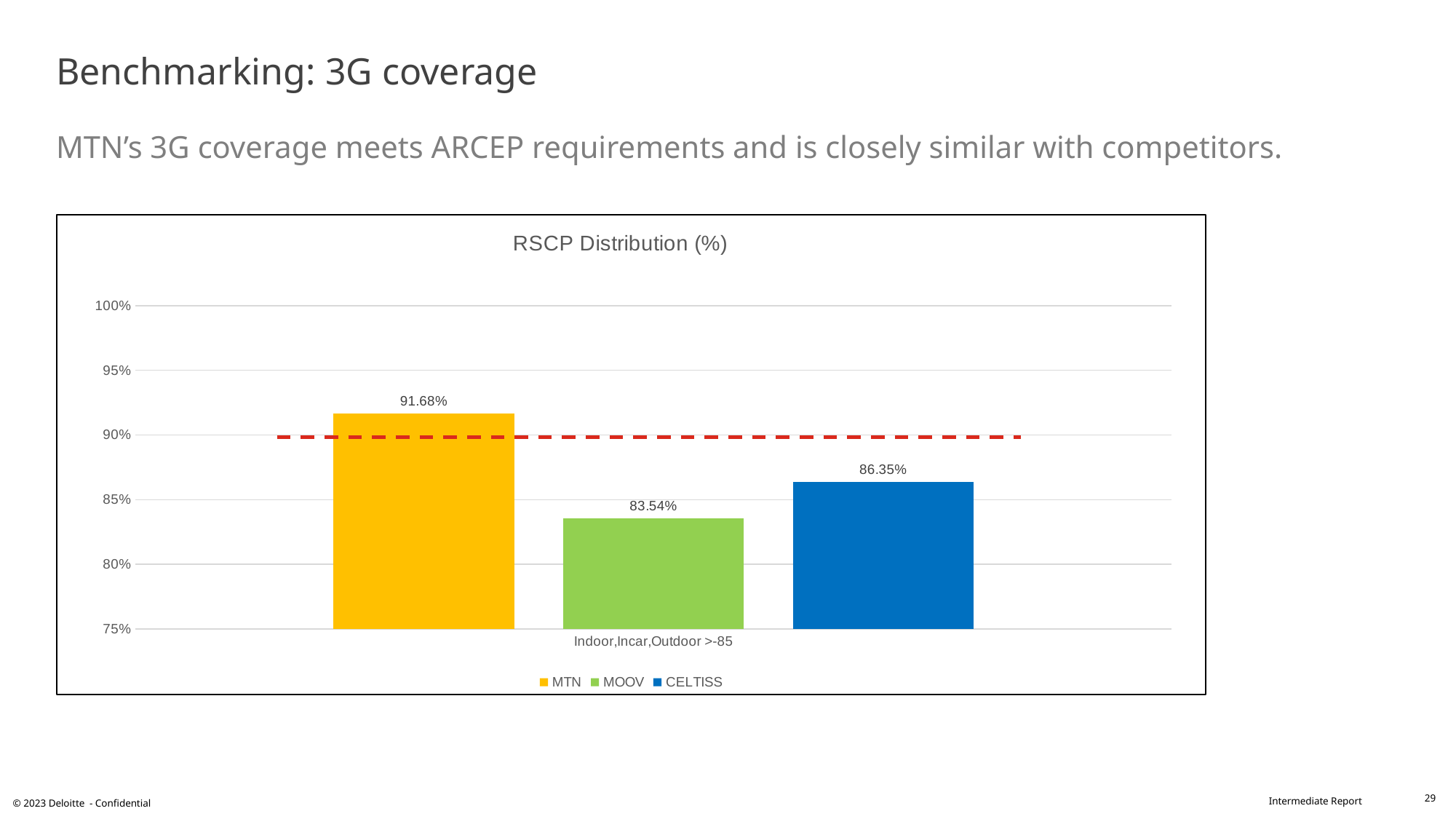
Which is larger, the value for CELTISS or the value for MOOV? CELTISS What is the value for MTN in the RSCP Distribution chart? 91.68% What kind of chart is shown on the slide? bar chart What is the title of the chart? RSCP Distribution (%) How many series does the legend list? 3 What is the difference between the MTN and MOOV values? 8.14% What is the value for CELTISS in the RSCP Distribution chart? 86.35% Is the value for CELTISS greater or less than 90%? less Which operator has the highest RSCP Distribution value? MTN What is the value for MOOV in the RSCP Distribution chart? 83.54% What is the difference between the CELTISS and MOOV values? 2.81% Which operator has the lowest RSCP Distribution value? MOOV